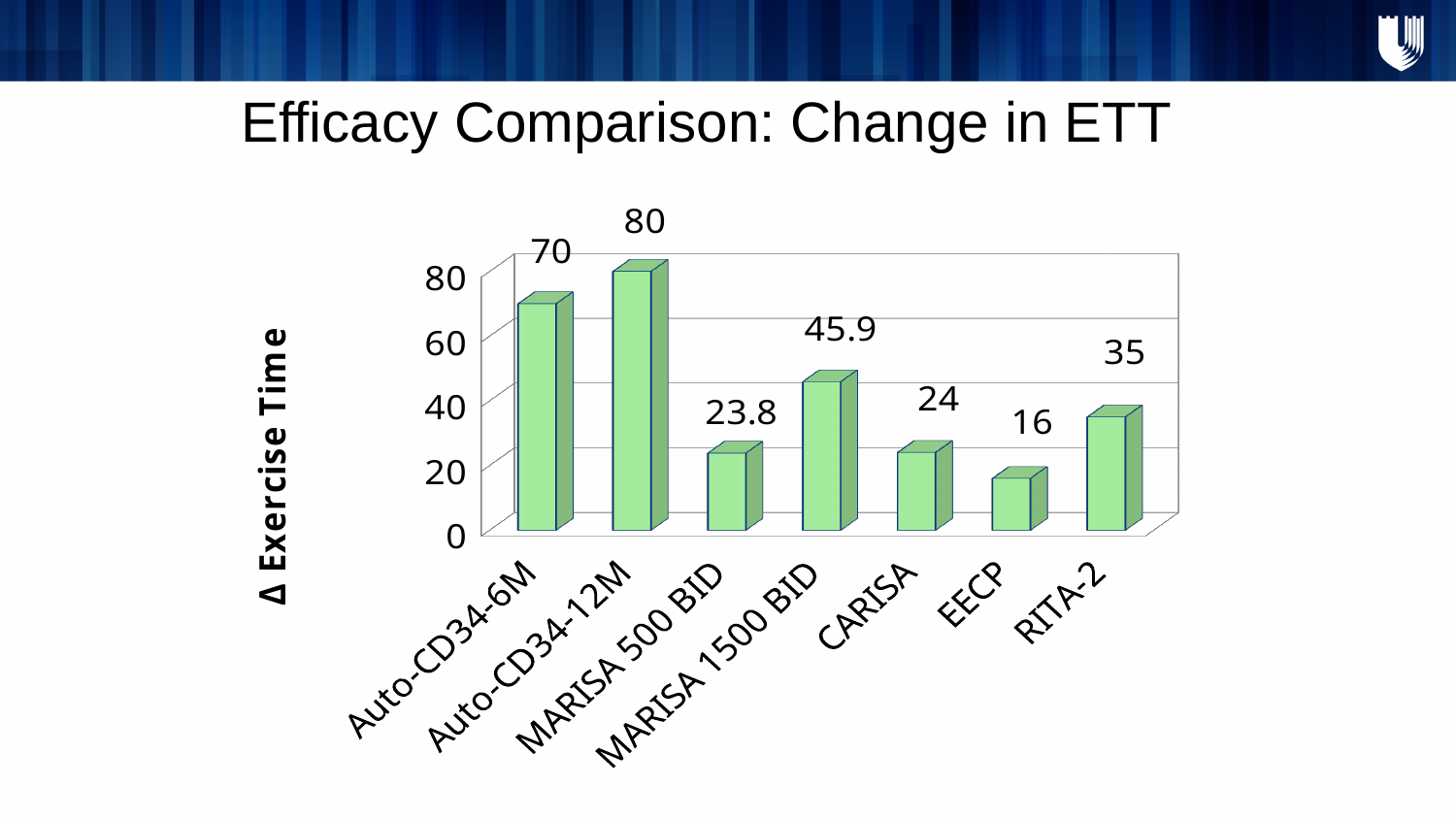
What is the value shown for EECP? 16 What is the difference between the values for Auto-CD34-12M and Auto-CD34-6M? 10 What is the label of the vertical axis? Δ Exercise Time What is the difference between the values for MARISA 1500 BID and MARISA 500 BID? 22.1 Which category has the highest change in exercise time? Auto-CD34-12M Which category has the lowest change in exercise time? EECP What kind of chart is shown on the slide? Bar chart What is the value shown for MARISA 1500 BID? 45.9 Which is larger, the value for CARISA or the value for RITA-2? RITA-2 What is the change in exercise time for Auto-CD34-12M? 80 How many categories are shown on the x axis? 7 What is the value shown for RITA-2? 35